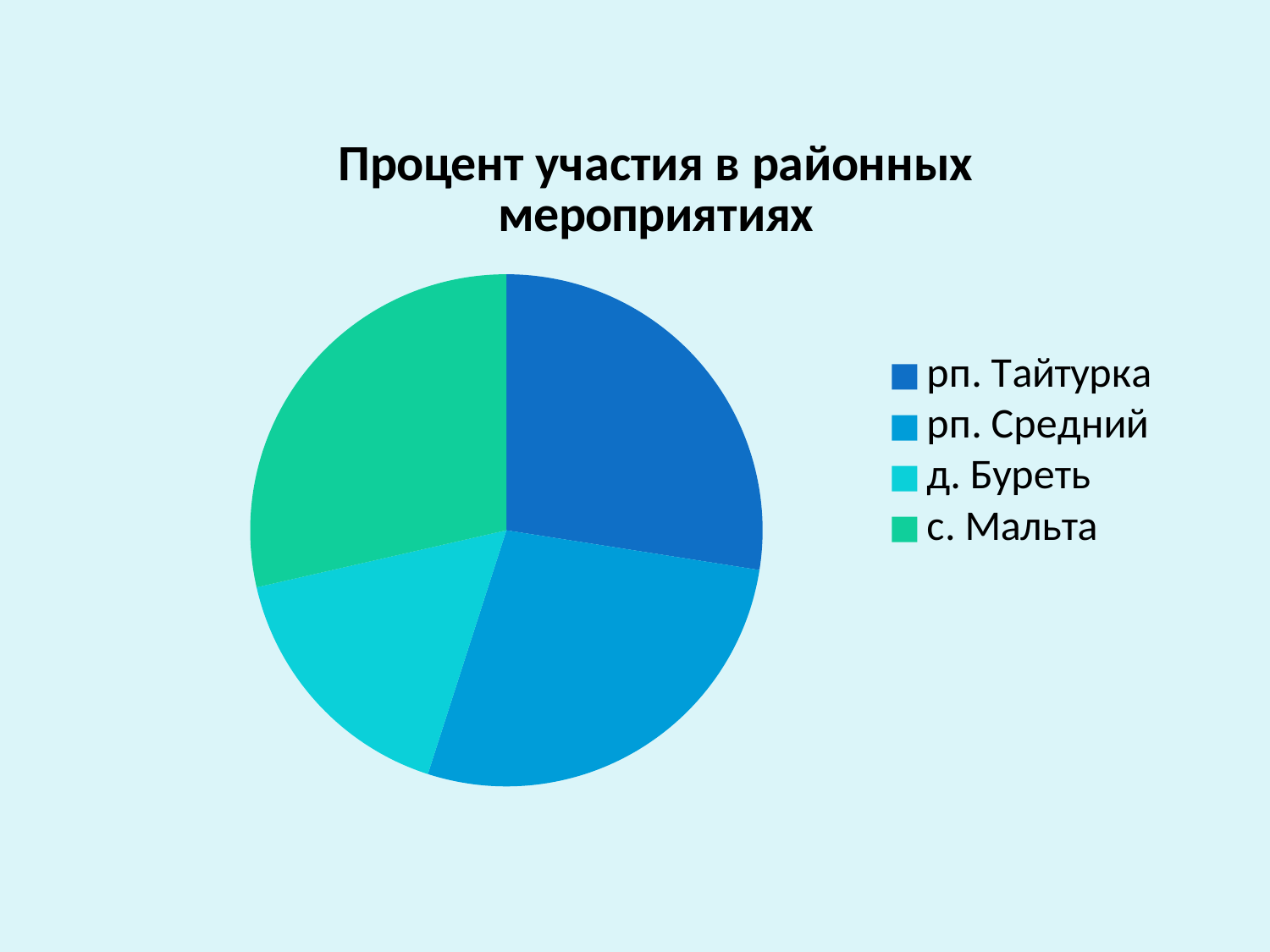
Which category is shown in green in the pie chart? с. Мальта Which slice is larger, с. Мальта or д. Буреть? с. Мальта What kind of chart is shown on the slide? pie chart Which slice is larger, рп. Средний or д. Буреть? рп. Средний What is the title of the chart? Процент участия в районных мероприятиях How many entries does the legend list? 4 Which slice is larger, рп. Тайтурка or д. Буреть? рп. Тайтурка Which category is listed first in the legend? рп. Тайтурка Which category has the smallest slice of the pie? д. Буреть How many slices does the pie chart have? 4